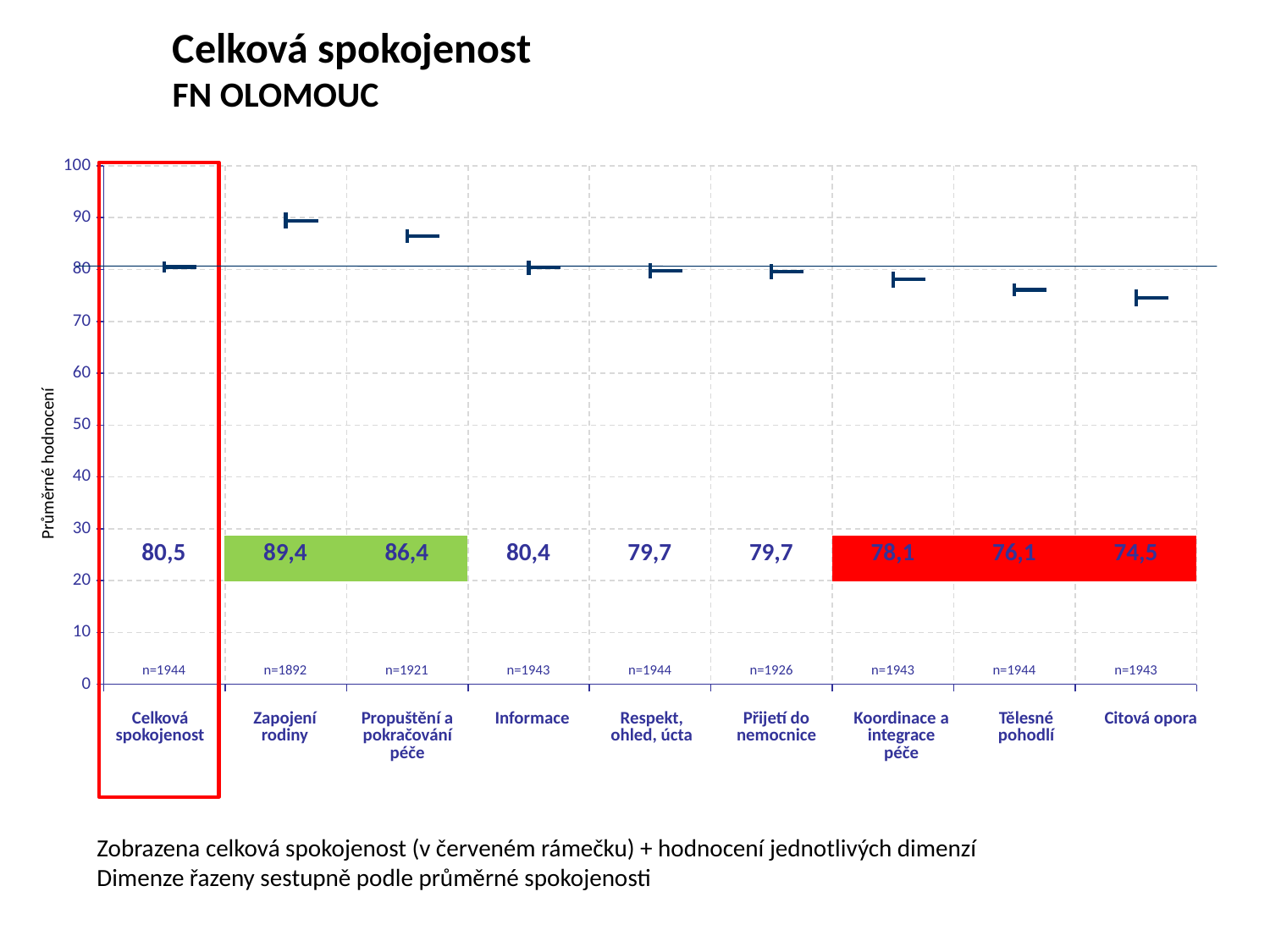
What is the value shown for Tělesné pohodlí? 76,1 What is the label of the y axis? Průměrné hodnocení Which is larger, the value for Informace or the value for Tělesné pohodlí? Informace What is the value shown for Celková spokojenost? 80,5 Which dimension has the highest value? Zapojení rodiny What is the difference between the values for Koordinace a integrace péče and Citová opora? 3,6 What is the value shown for Zapojení rodiny? 89,4 What is the sample size (n) shown for Zapojení rodiny? n=1892 What is the value shown for Citová opora? 74,5 Which dimension has the lowest value? Citová opora How many categories are shown on the x axis? 9 What is the difference between the values for Zapojení rodiny and Propuštění a pokračování péče? 3,0